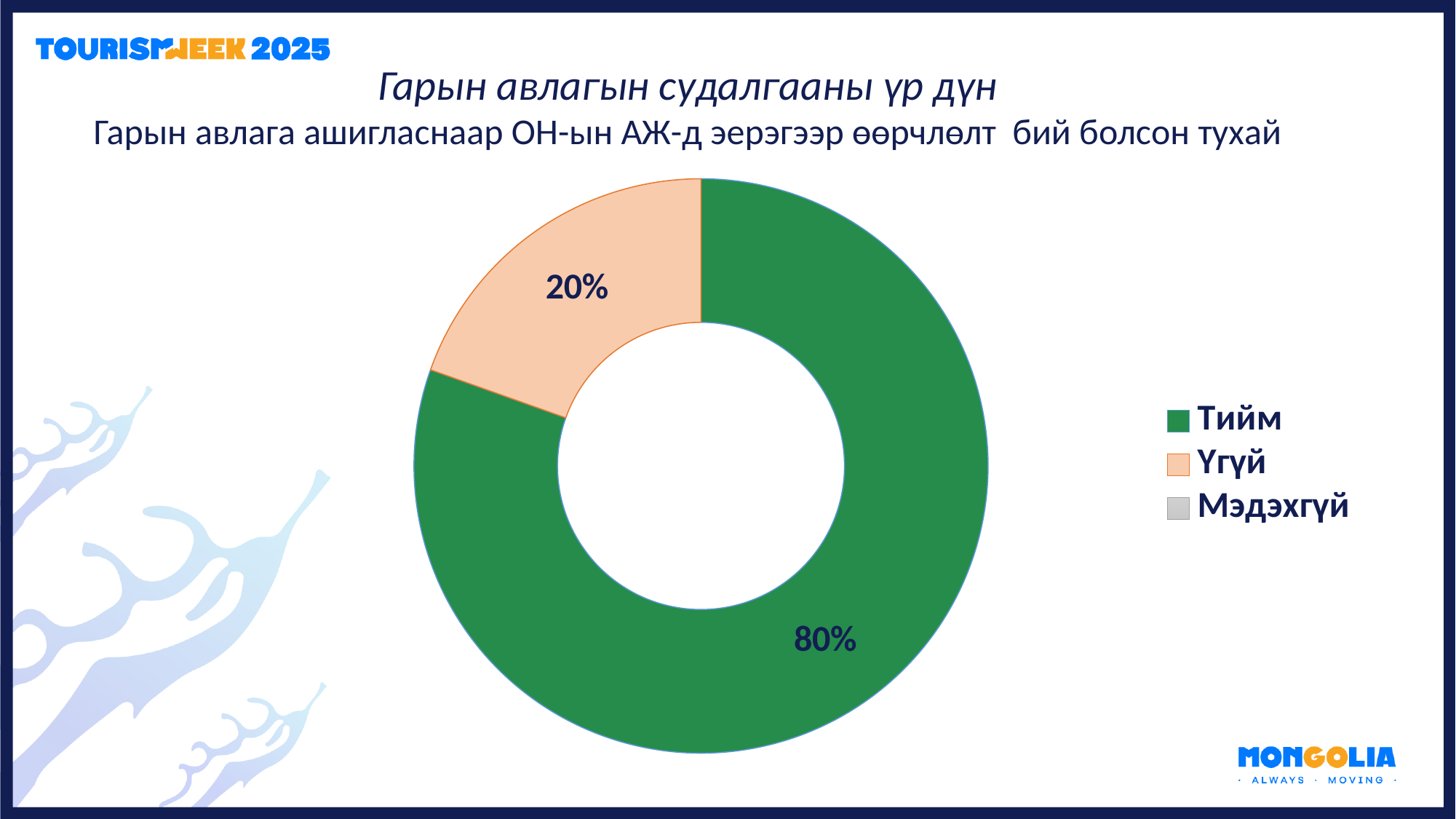
What percentage is shown for Тийм? 80% Is the share for Тийм greater or less than 50%? greater Which of the two labelled slices is smaller, Тийм or Үгүй? Үгүй What percentage is shown for Үгүй? 20% Which legend entry has no visible slice in the chart? Мэдэхгүй How many entries does the legend list? 3 What share of the chart does the Үгүй slice represent? 20% What colour is the Тийм slice? Green How many slices with data labels are visible in the chart? 2 What is the difference in percentage points between Тийм and Үгүй? 60 What kind of chart is shown on the slide? Pie chart (donut) Which category has the largest share of the chart? Тийм